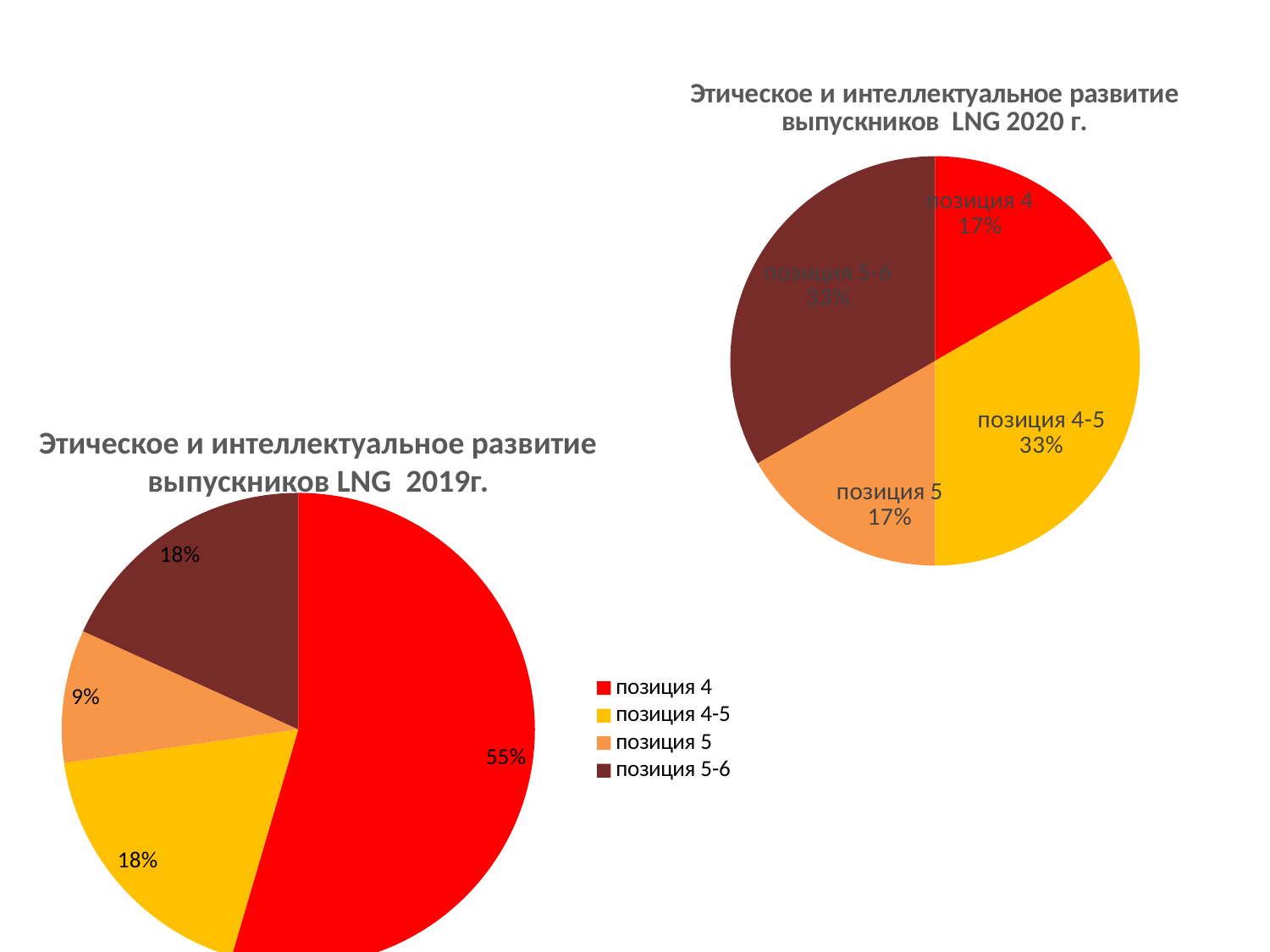
In the 2019 pie chart, which category has the smallest share? позиция 5 In the 2020 pie chart, which is larger: the share of позиция 5-6 or the share of позиция 4? позиция 5-6 In the 2019 pie chart, which category has the largest share? позиция 4 How many entries does the legend on the slide list? 4 In the 2019 pie chart, what share does позиция 5 have? 9% In the 2019 pie chart (Этическое и интеллектуальное развитие выпускников LNG 2019г.), what share does позиция 4 have? 55% In the 2019 pie chart, what is the difference between the share of позиция 4 and the share of позиция 4-5? 37% How many slices does the 2020 pie chart have? 4 In the legend, which colour represents позиция 4-5? Yellow What type of chart is the 2019 chart on the left of the slide? Pie chart In the 2020 pie chart, what share does позиция 5 have? 17% In the 2020 pie chart (Этическое и интеллектуальное развитие выпускников LNG 2020 г.), what share does позиция 4-5 have? 33%